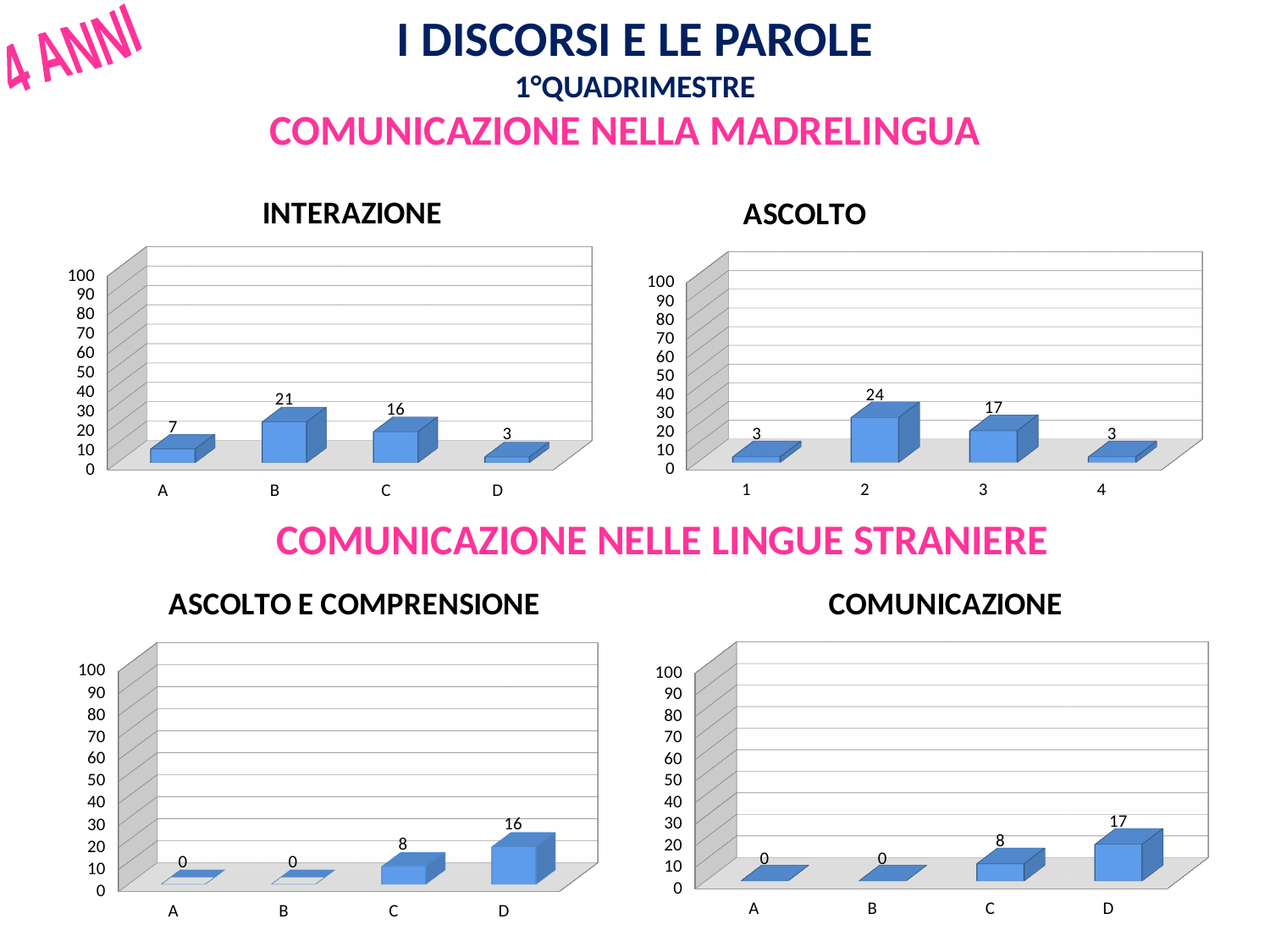
In the ASCOLTO E COMPRENSIONE chart, what is the value for category D? 16 In the ASCOLTO chart, what is the value for category 2? 24 What kind of chart is the INTERAZIONE chart? Bar chart In the ASCOLTO chart, which category has the highest value? 2 In the INTERAZIONE chart, what is the value for category B? 21 In the ASCOLTO E COMPRENSIONE chart, how many categories are shown on the x axis? 4 In the COMUNICAZIONE chart, what is the difference between the values for D and C? 9 In the INTERAZIONE chart, which category has the lowest value? D In the COMUNICAZIONE chart, which is larger, the value for C or the value for D? D In the ASCOLTO chart, what is the difference between the values for category 2 and category 3? 7 In the COMUNICAZIONE chart, what is the value for category C? 8 In the INTERAZIONE chart, is the value for category B greater or less than 30? less